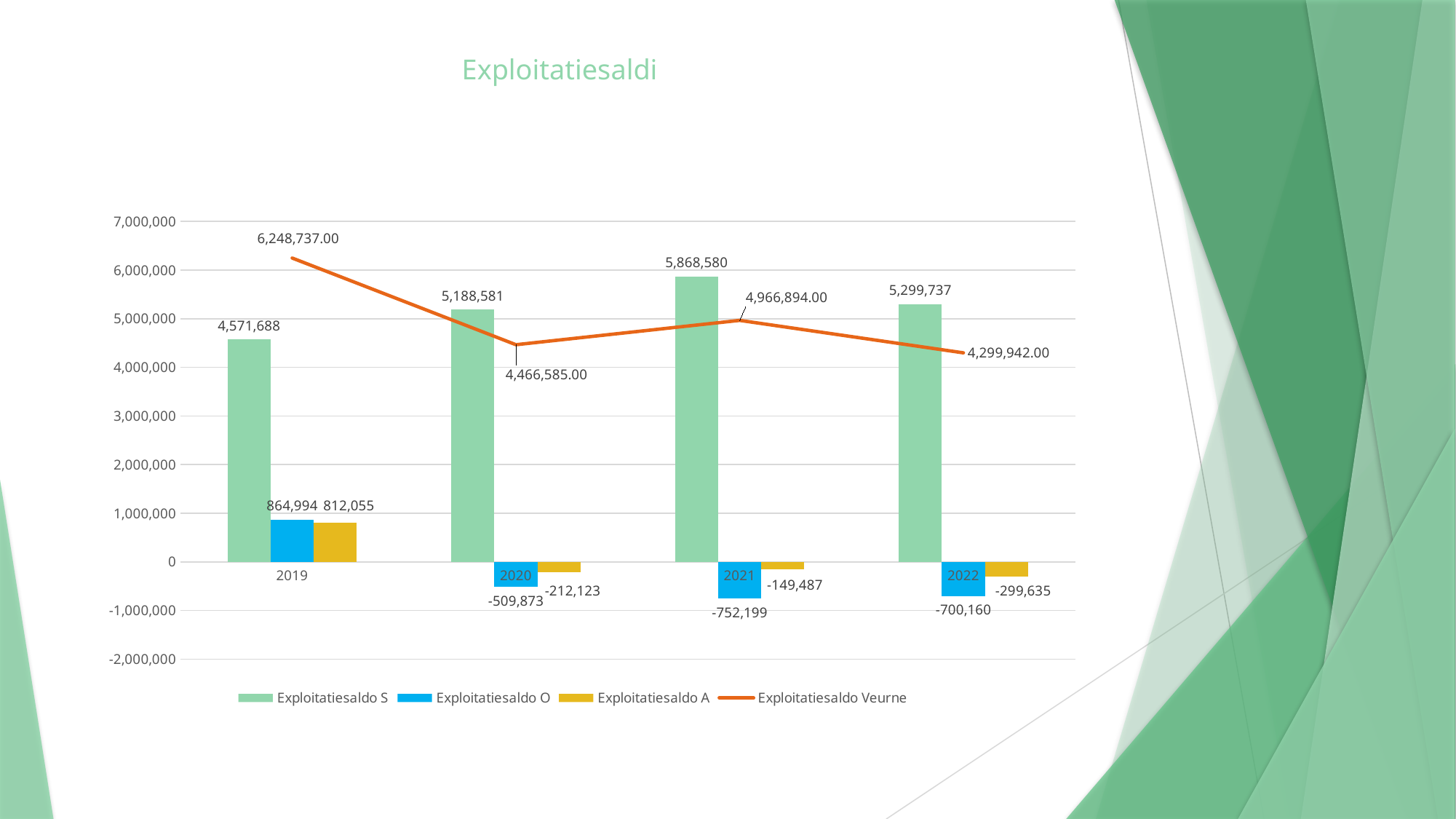
What is the value of Exploitatiesaldo O in 2022? -700,160 What is the value of Exploitatiesaldo Veurne in 2019? 6,248,737.00 What is the title of the chart? Exploitatiesaldi Which is larger in 2020: Exploitatiesaldo S or Exploitatiesaldo Veurne? Exploitatiesaldo S In which year is Exploitatiesaldo Veurne the lowest? 2022 Does Exploitatiesaldo Veurne rise or fall from 2019 to 2020? fall How many series does the legend list? 4 What is the value of Exploitatiesaldo A in 2020? -212,123 In which year is Exploitatiesaldo S the highest? 2021 What is the difference between Exploitatiesaldo S in 2021 and in 2019? 1,296,892 How many years are shown on the x axis? 4 What is the value of Exploitatiesaldo S in 2021? 5,868,580